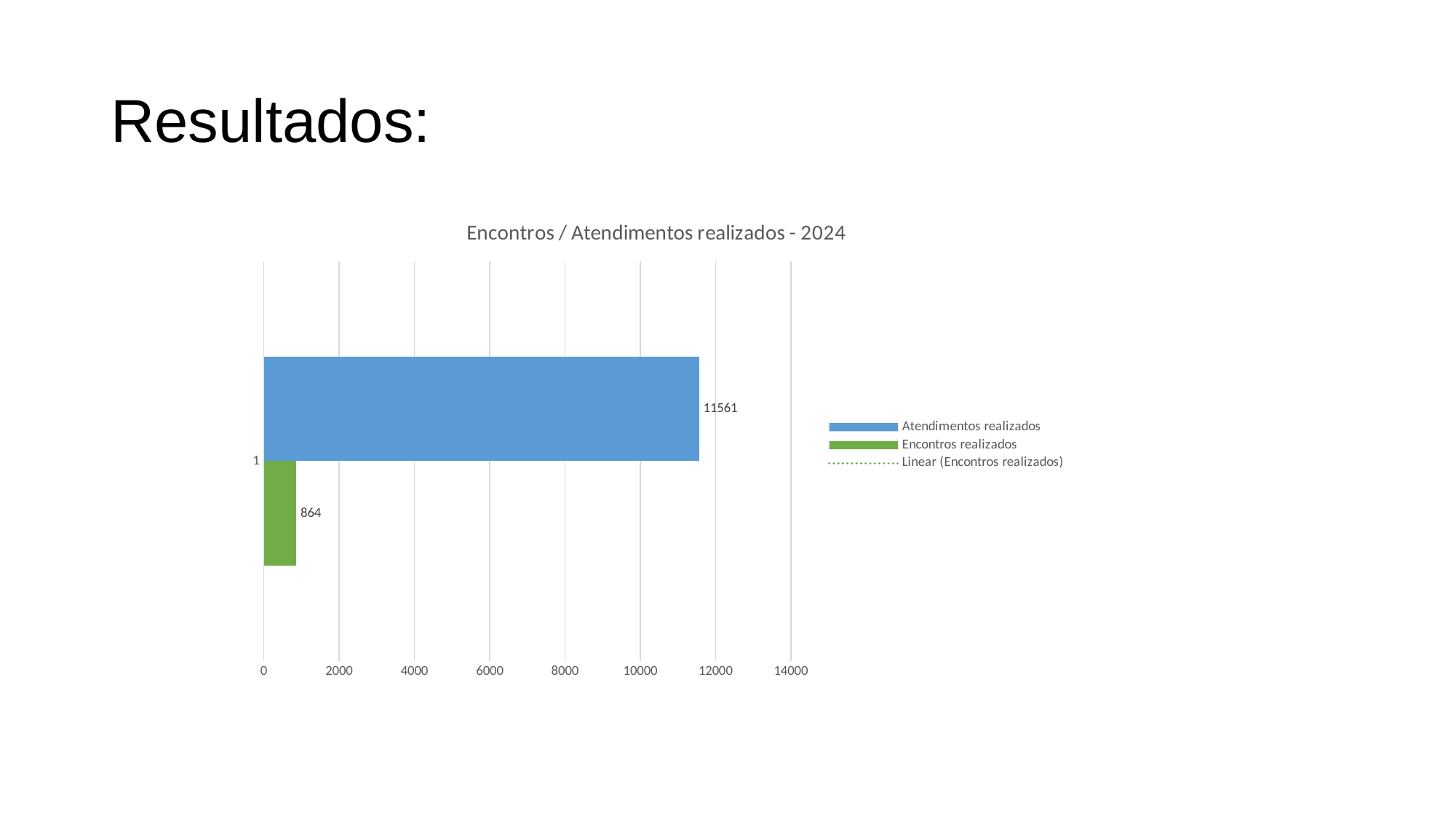
How many entries does the legend list? 3 Is the value for Atendimentos realizados greater or less than 10000? greater What is the difference between Atendimentos realizados and Encontros realizados? 10697 Which series has the lowest plotted value? Encontros realizados What colour is the bar for Encontros realizados? Green Is the value for Encontros realizados greater or less than 2000? less Which series has the higher value, Atendimentos realizados or Encontros realizados? Atendimentos realizados What is the highest value shown on the x axis? 14000 What is the value for Atendimentos realizados? 11561 What kind of chart is shown on the slide? Bar chart What is the value for Encontros realizados? 864 What is the title of the chart? Encontros / Atendimentos realizados - 2024